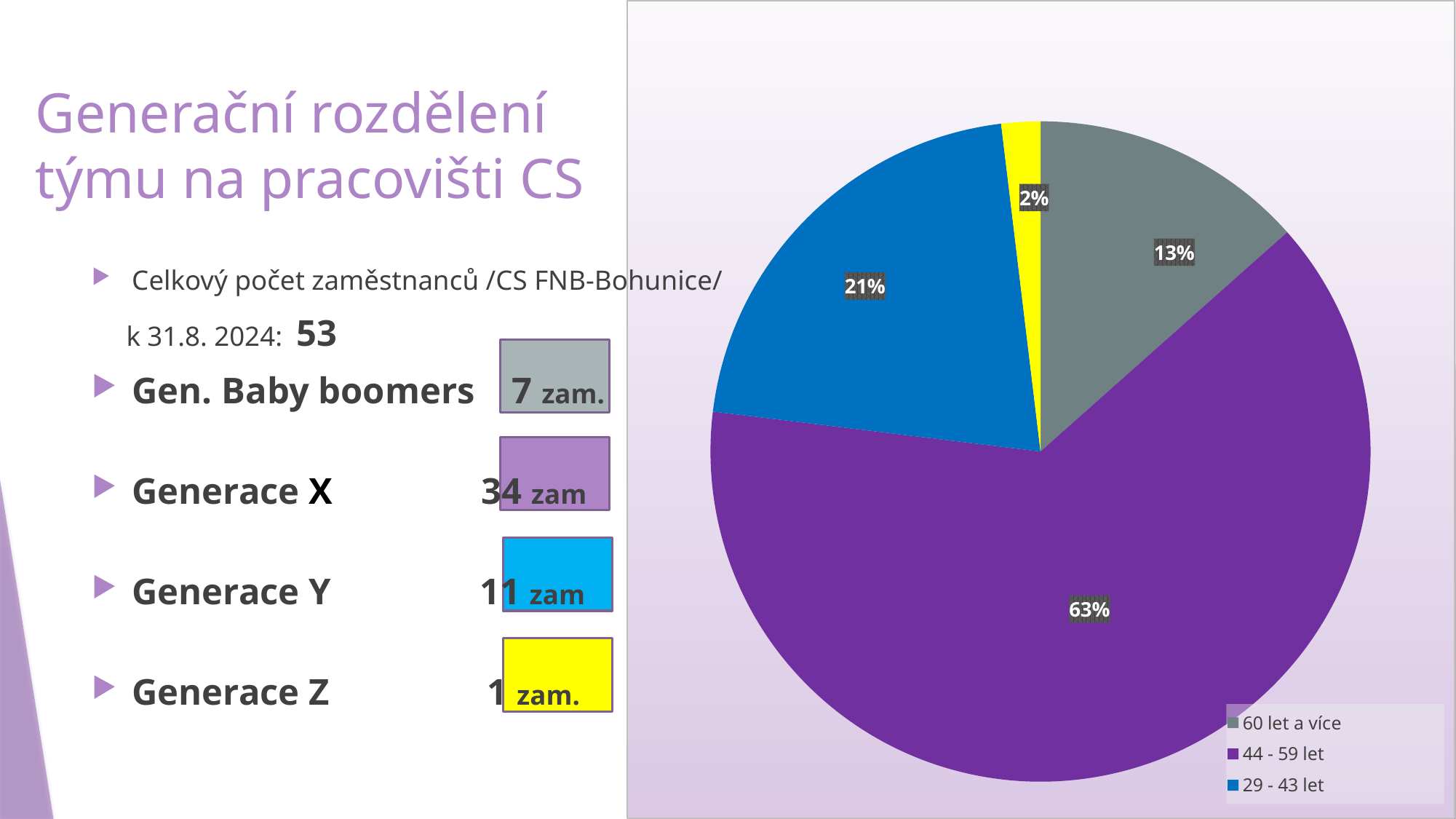
Which age group has the largest slice of the pie? 44 - 59 let How many slices does the pie chart have? 4 Which slice is larger, 60 let a více or 29 - 43 let? 29 - 43 let How many entries does the legend of the pie chart list? 3 What is the difference in percentage points between the 44 - 59 let slice and the 29 - 43 let slice? 42 What percentage does the 29 - 43 let slice show? 21% Does the 44 - 59 let slice account for more or less than half of the pie? more What percentage does the 44 - 59 let slice show? 63% What type of chart is shown on the slide? pie chart What colour is the 44 - 59 let slice in the pie chart? purple What percentage does the 60 let a více slice show? 13% What percentage is printed on the smallest slice of the pie? 2%